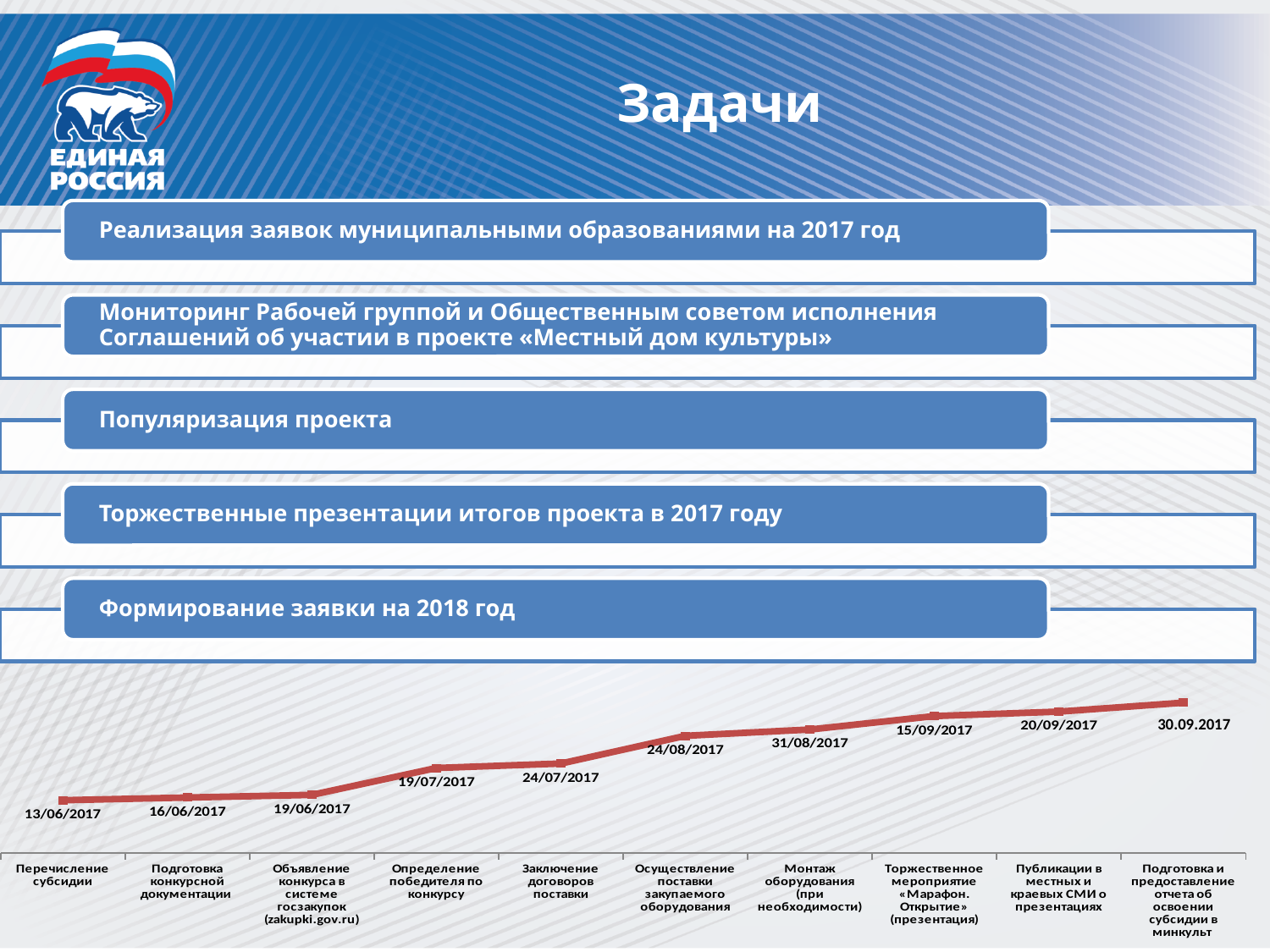
Which stage has the latest date on the chart? Подготовка и предоставление отчета об освоении субсидии в минкульт How many stages (data points) are plotted on the line chart? 10 What date is labelled for the stage "Перечисление субсидии"? 13/06/2017 What date is labelled for the stage "Определение победителя по конкурсу"? 19/07/2017 Does the line rise or fall from left to right across the stages? Rises What date is labelled for the stage "Торжественное мероприятие «Марафон. Открытие» (презентация)"? 15/09/2017 What date is labelled for the stage "Осуществление поставки закупаемого оборудования"? 24/08/2017 What date is labelled for the last stage, "Подготовка и предоставление отчета об освоении субсидии в минкульт"? 30.09.2017 What date is labelled for the stage "Заключение договоров поставки"? 24/07/2017 What kind of chart is shown at the bottom of the slide? Line chart What date is labelled for the stage "Подготовка конкурсной документации"? 16/06/2017 What date is labelled for the stage "Монтаж оборудования (при необходимости)"? 31/08/2017